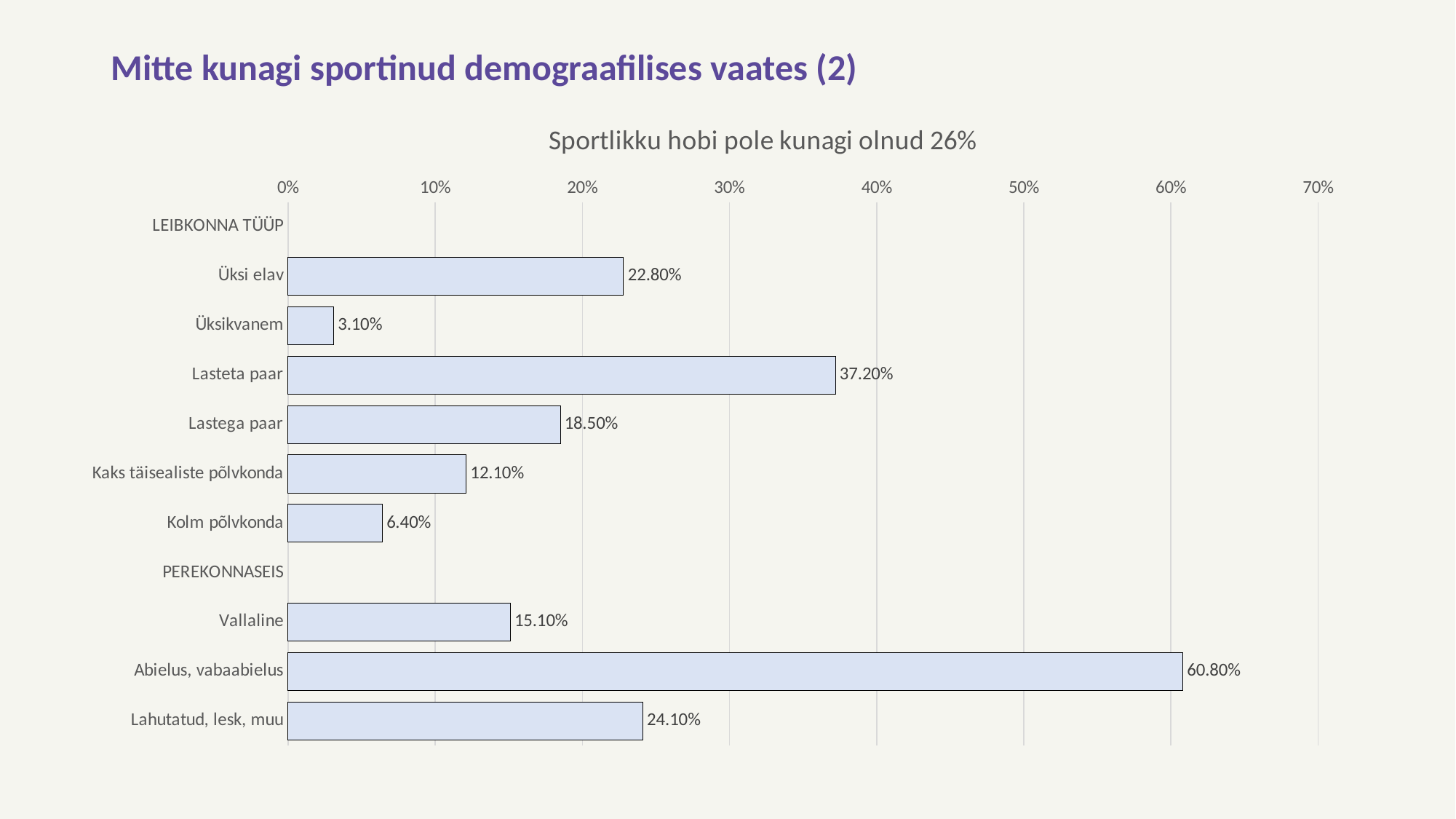
What is the value for Kaks täisealiste põlvkonda? 12.10% Which category has the lowest value? Üksikvanem What is the value for Üksikvanem? 3.10% What is the difference between the values for Lasteta paar and Üksi elav? 14.40 percentage points Which is larger, the value for Vallaline or the value for Lahutatud, lesk, muu? Lahutatud, lesk, muu Is the value for Lastega paar greater or less than 20%? less Which category has the highest value? Abielus, vabaabielus How many bars are plotted in the chart? 9 What is the value for Abielus, vabaabielus? 60.80% What is the title of the chart? Sportlikku hobi pole kunagi olnud 26% What kind of chart is shown on the slide? Bar chart What is the value for Lasteta paar? 37.20%